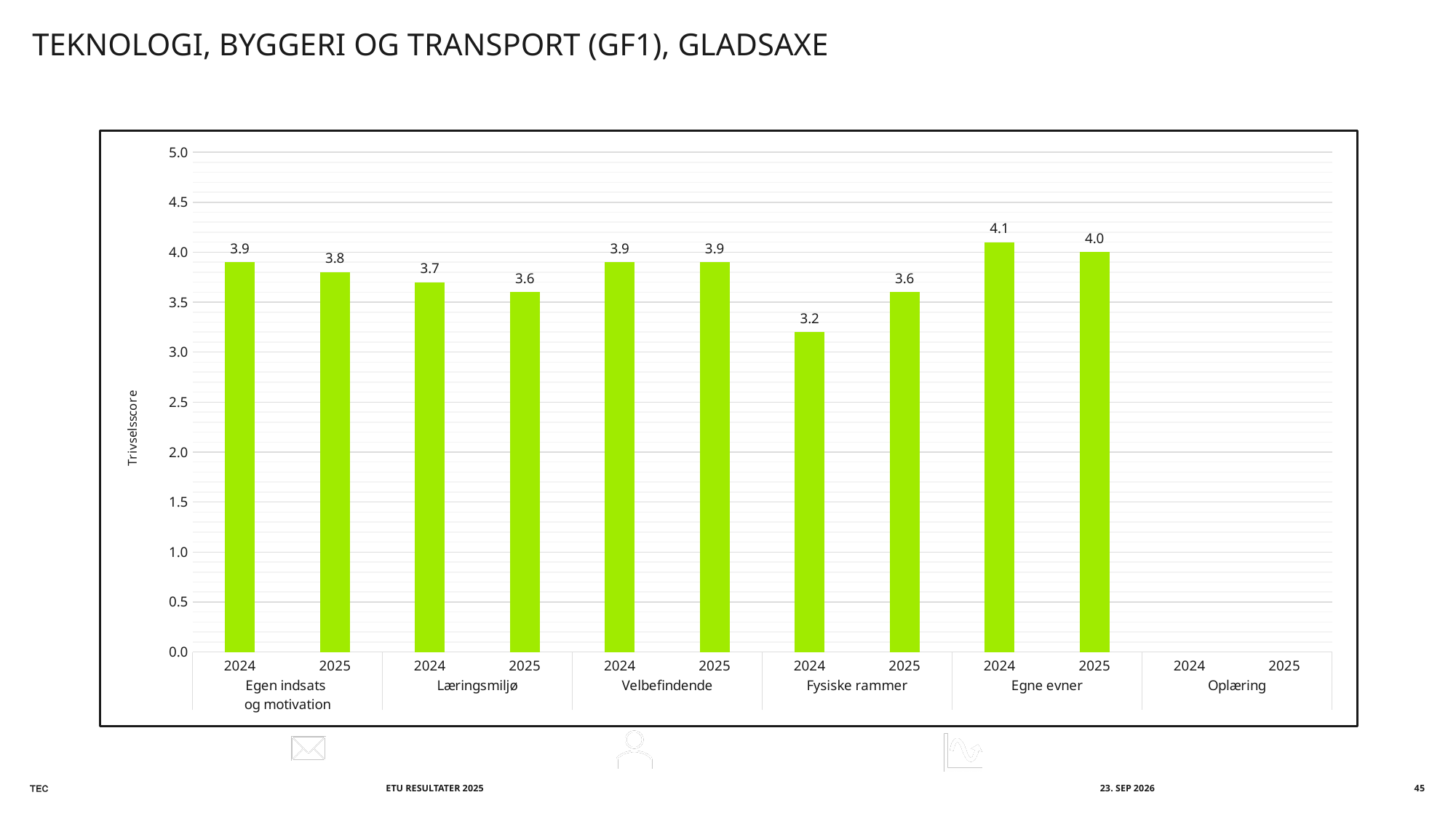
What kind of chart is shown on the slide? Bar chart What is the value for Egne evner in 2025? 4.0 Which is larger, the 2024 value for Læringsmiljø or the 2024 value for Velbefindende? Velbefindende 2024 Which bar has the lowest value on the chart? Fysiske rammer 2024 How many category groups are shown on the x axis? 6 What is the difference between the 2025 and 2024 values for Fysiske rammer? 0.4 What is the value for Fysiske rammer in 2024? 3.2 Which bar has the highest value on the chart? Egne evner 2024 What is the label of the y axis? Trivselsscore What is the value for Læringsmiljø in 2025? 3.6 What is the value for Egen indsats og motivation in 2024? 3.9 Is the value for Egne evner in 2024 greater or less than 4.0? greater